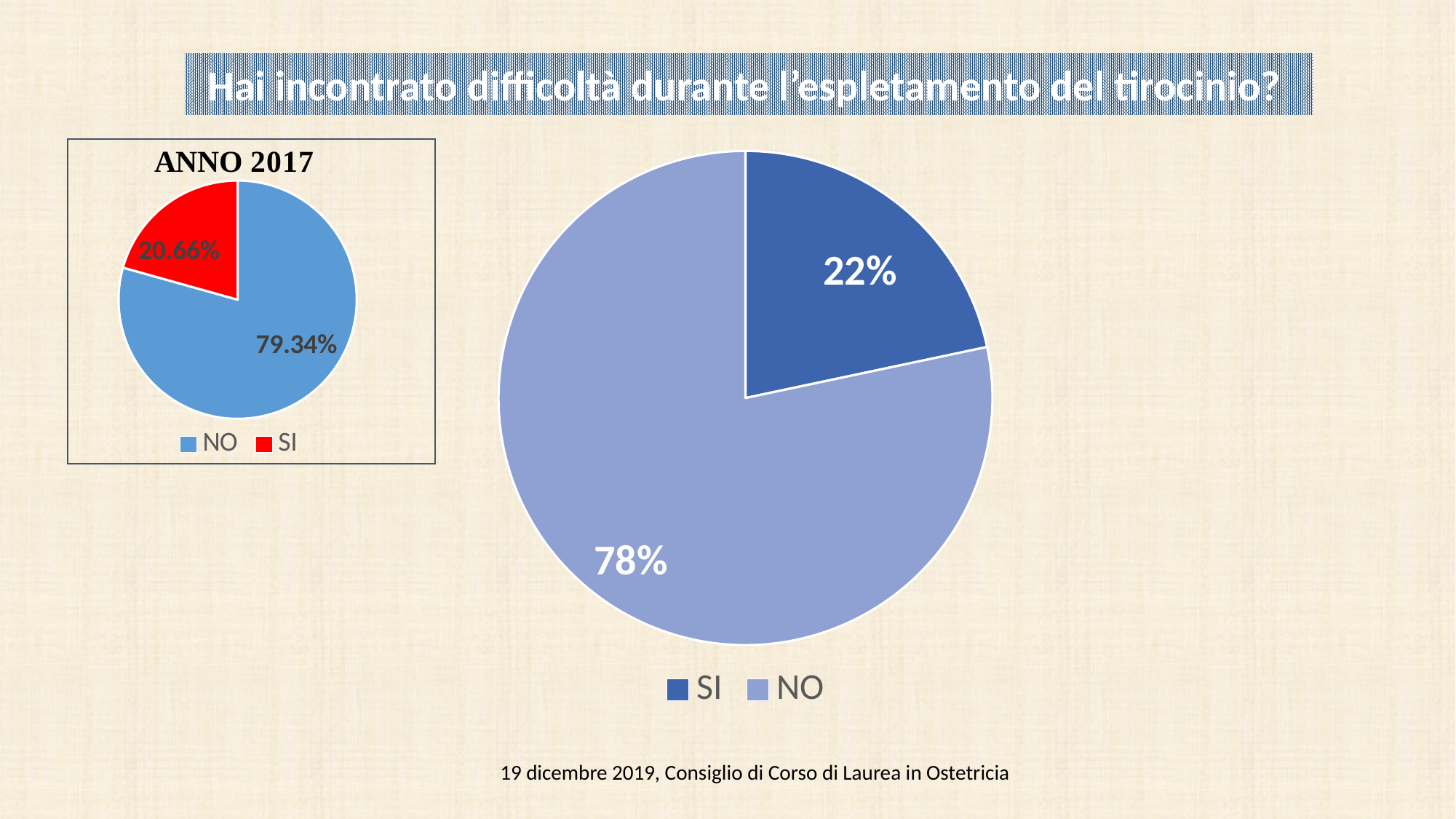
In the ANNO 2017 pie chart, what is the share for NO? 79.34% In the large pie chart on the right, which category has the smallest slice? SI In the ANNO 2017 pie chart, what colour is the SI slice? red How many slices does the ANNO 2017 pie chart have? 2 In the ANNO 2017 pie chart, which category has the largest slice? NO In the large pie chart on the right, what is the difference between the NO and SI values? 56% In the ANNO 2017 pie chart, what is the share for SI? 20.66% In the ANNO 2017 pie chart, what is the difference between the NO and SI shares? 58.68% In the large pie chart on the right, what is the value for SI? 22% In the large pie chart on the right, what is the value for NO? 78% What type of chart is the large chart on the right? pie chart In the large pie chart on the right, is the value for SI larger or smaller than the value for NO? smaller